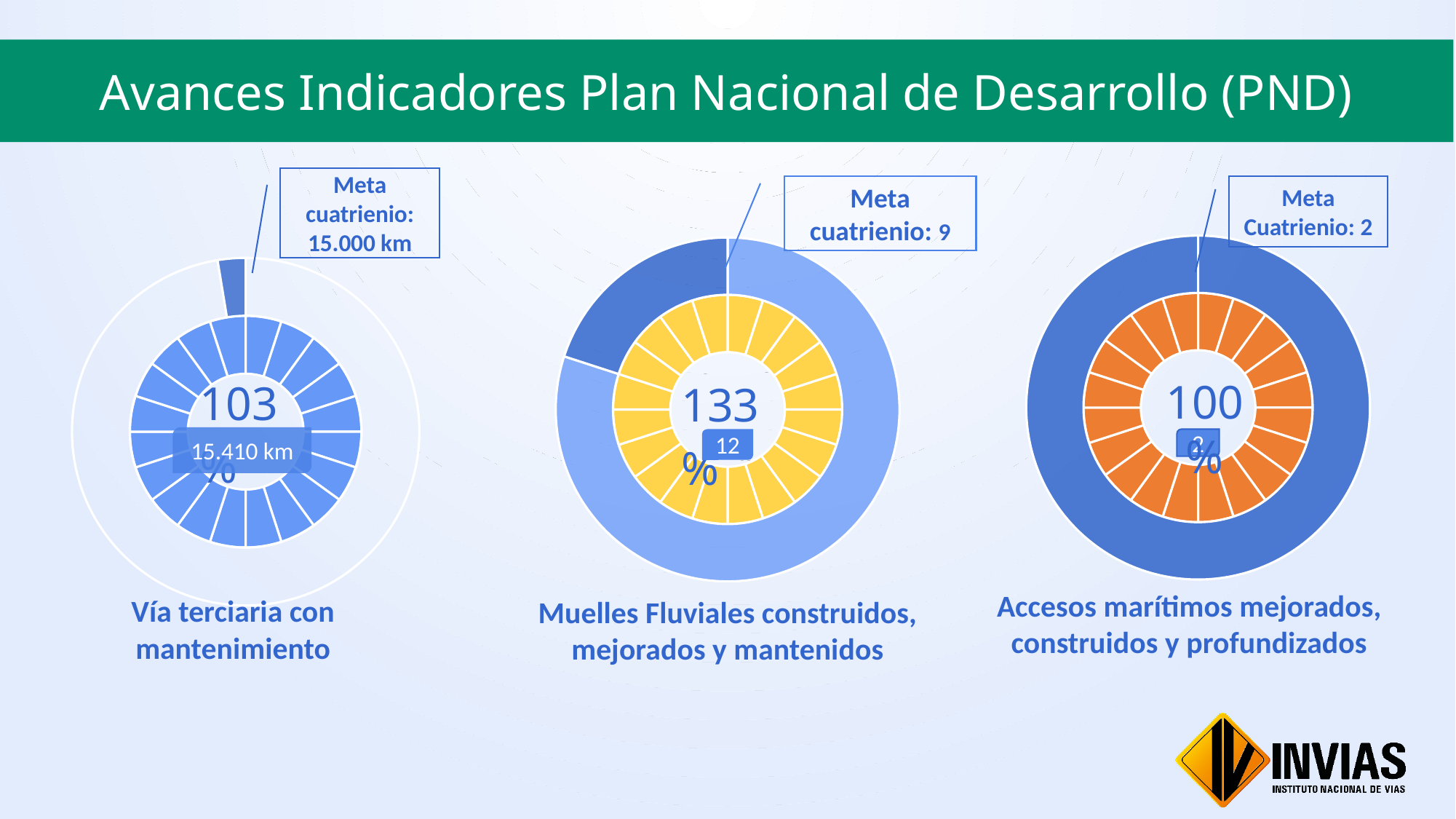
Which of the three indicators shows the lowest percentage of progress? Accesos marítimos mejorados, construidos y profundizados How many kilometres are shown as achieved on the 'Vía terciaria con mantenimiento' chart? 15.410 km How many indicator charts are shown on the slide? 3 On the 'Muelles Fluviales' chart, by how much does the achieved number (12) exceed the meta cuatrienio (9)? 3 What is the 'Meta cuatrienio' for the 'Vía terciaria con mantenimiento' chart? 15.000 km Which of the three indicators shows the highest percentage of progress? Muelles Fluviales construidos, mejorados y mantenidos What percentage is shown in the centre of the 'Accesos marítimos mejorados, construidos y profundizados' chart? 100% What percentage is shown in the centre of the 'Vía terciaria con mantenimiento' chart? 103% What is the 'Meta cuatrienio' for the 'Muelles Fluviales construidos, mejorados y mantenidos' chart? 9 What number of muelles is shown as achieved on the 'Muelles Fluviales construidos, mejorados y mantenidos' chart? 12 What percentage is shown in the centre of the 'Muelles Fluviales construidos, mejorados y mantenidos' chart? 133% What is the 'Meta Cuatrienio' for the 'Accesos marítimos mejorados, construidos y profundizados' chart? 2